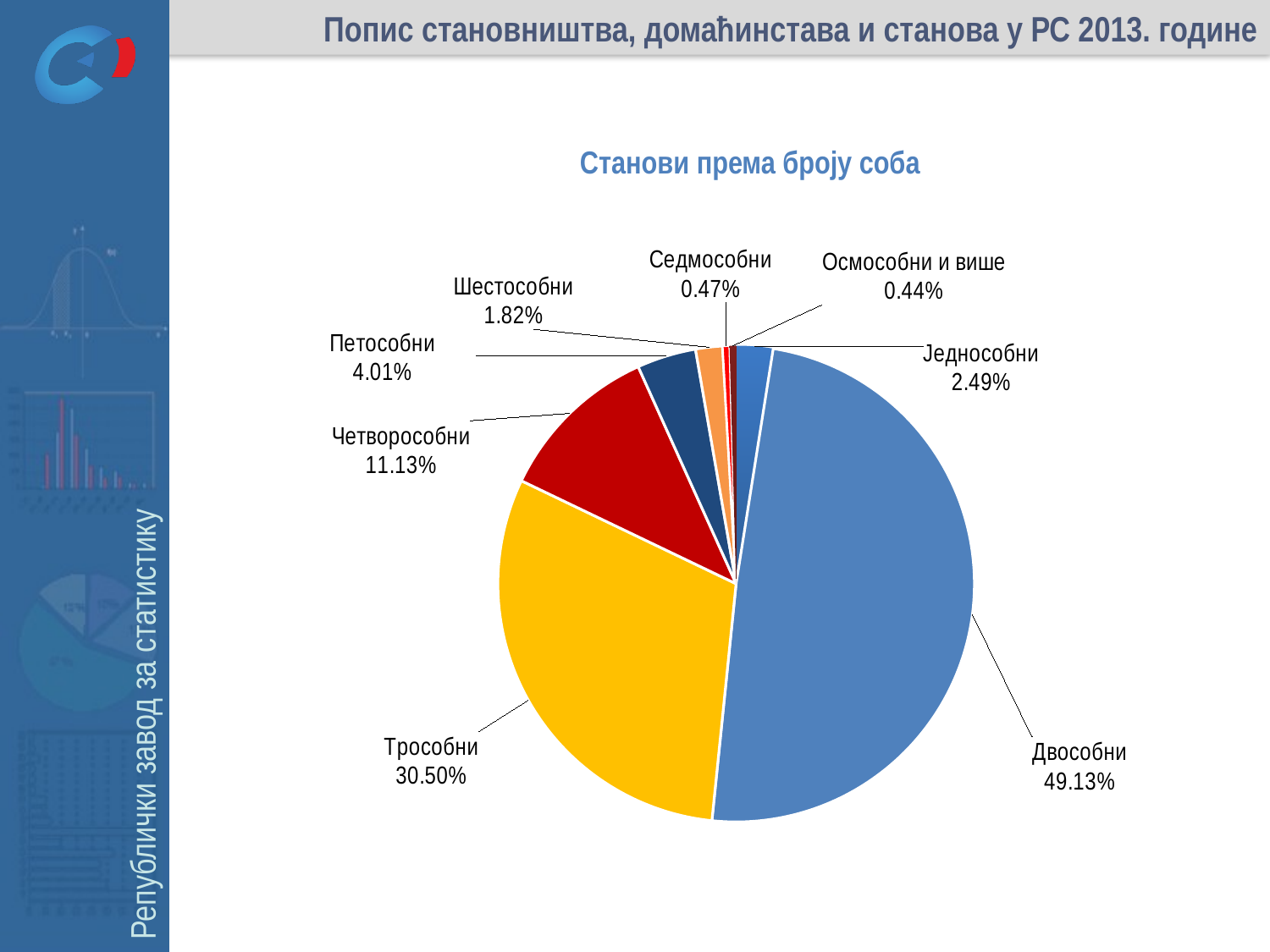
Which category has the smallest slice of the pie? Осмособни и више What is the value shown for Једнособни? 2.49% What share of the pie does Двособни represent? 49.13% How many categories are shown in the pie chart? 8 What is the value shown for Четворособни? 11.13% Which is larger, the value for Петособни or the value for Шестособни? Петособни Which category has the largest slice of the pie? Двособни What is the value shown for Трособни? 30.50% What is the value shown for Осмособни и више? 0.44% What kind of chart is shown on the slide? Pie chart What is the difference between the values for Двособни and Трособни? 18.63% What is the title of the chart? Станови према броју соба